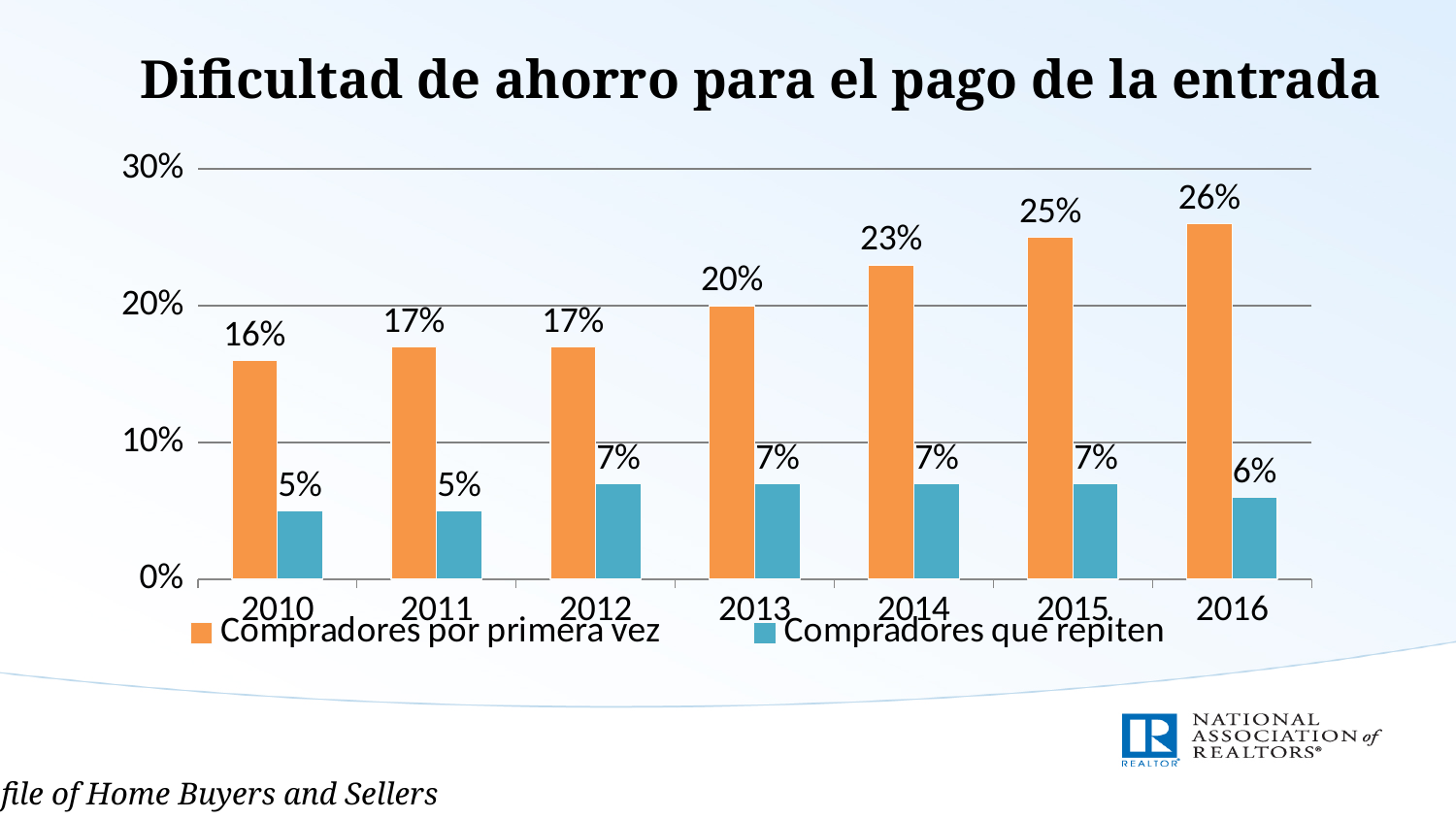
What is the difference between Compradores por primera vez and Compradores que repiten in 2014? 16% Which is larger in 2015: Compradores por primera vez or Compradores que repiten? Compradores por primera vez In which year is the value for Compradores por primera vez lowest? 2010 Is the value for Compradores por primera vez in 2016 greater or less than 20%? greater What is the value for Compradores por primera vez in 2013? 20% What is the value for Compradores por primera vez in 2010? 16% How many years are shown on the x axis? 7 Does the value for Compradores por primera vez rise or fall from 2010 to 2016? Rise What is the value for Compradores que repiten in 2016? 6% In which year is the value for Compradores por primera vez highest? 2016 How many series does the legend list? 2 What kind of chart is shown on the slide? Bar chart